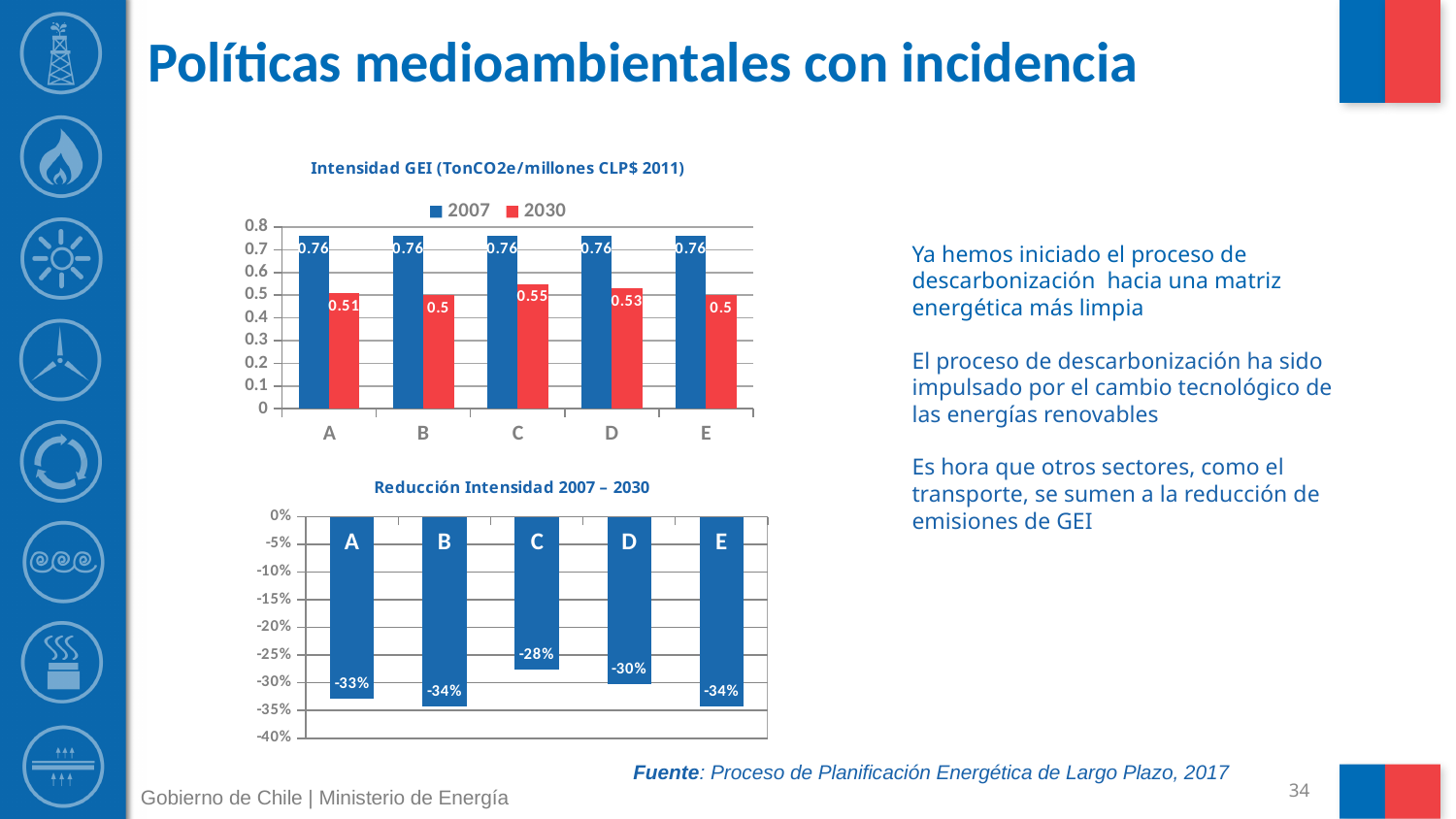
In the 'Reducción Intensidad 2007 – 2030' chart, what is the value for scenario C? -28% In the 'Intensidad GEI' chart, which scenario has the highest 2030 value? C In the 'Reducción Intensidad 2007 – 2030' chart, which scenario shows the smallest reduction? C In the 'Intensidad GEI' chart, which is larger for scenario B: the 2007 value or the 2030 value? 2007 In the 'Intensidad GEI' chart, how many scenarios are shown on the x axis? 5 In the 'Reducción Intensidad 2007 – 2030' chart, what is the difference between the values for scenarios B and C? 6% In the 'Intensidad GEI' chart, what is the difference between the 2007 and 2030 values for scenario D? 0.23 In the 'Intensidad GEI' chart, what is the 2030 value for scenario C? 0.55 In the 'Intensidad GEI' chart, what is the 2007 value for scenario A? 0.76 What kind of chart is the 'Reducción Intensidad 2007 – 2030' chart? Bar chart In the 'Reducción Intensidad 2007 – 2030' chart, what is the value for scenario D? -30% In the 'Intensidad GEI' chart, how many series does the legend list? 2